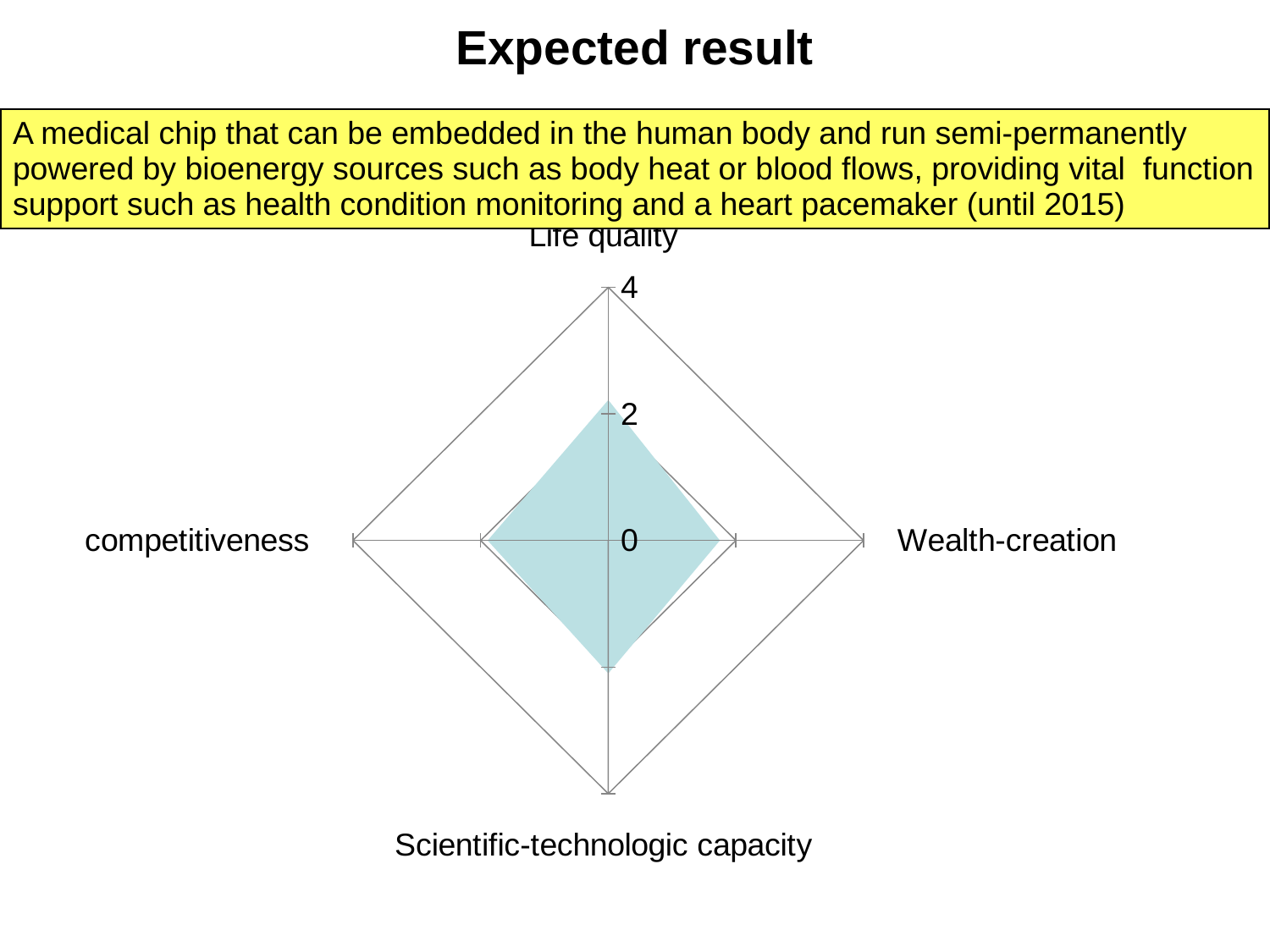
Is the value for Scientific-technologic capacity greater or less than 4? less Which is larger, the value for Life quality or the value for Wealth-creation? Life quality How many categories (axes) does the radar chart have? 4 Which category is labelled at the bottom of the radar chart? Scientific-technologic capacity Is the value for Life quality greater or less than 4? less Is the value for Wealth-creation greater or less than 2? less Which category has the lowest value on the radar chart? Wealth-creation What kind of chart is shown on the slide? radar chart What is the maximum value shown on the radar chart's axis scale? 4 Which category has the highest value on the radar chart? Life quality